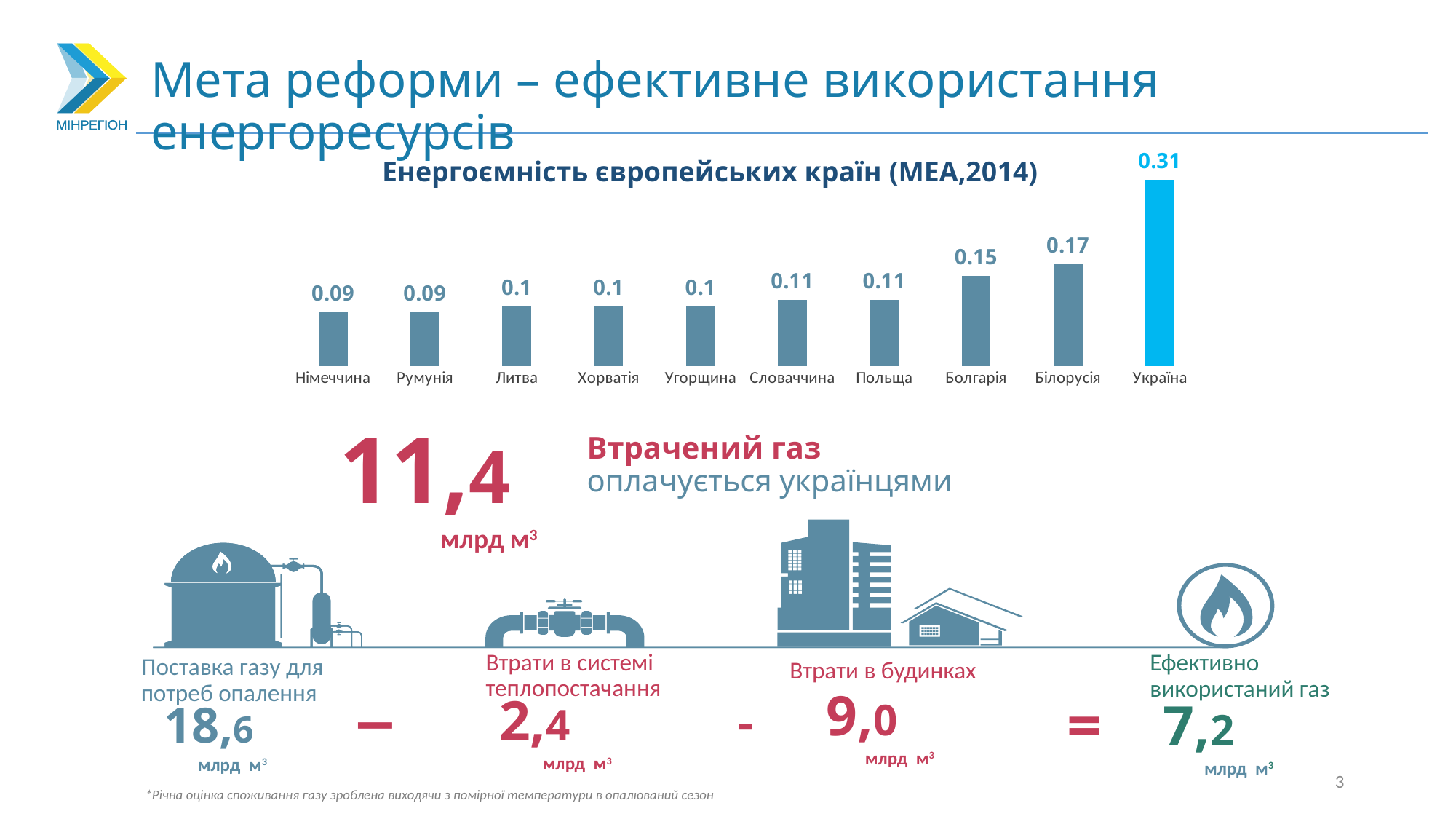
What is the value for Білорусія in the chart? 0.17 What is the value for Україна in the chart 'Енергоємність європейських країн (МЕА,2014)'? 0.31 How many countries are shown in the chart? 10 What is the value for Німеччина in the chart? 0.09 What is the value for Словаччина in the chart? 0.11 What is the difference between the values for Болгарія and Польща? 0.04 What is the difference between the values for Україна and Білорусія? 0.14 Do the values in the chart rise or fall from left to right? Rise Which has a larger value, Болгарія or Польща? Болгарія Which country has the highest value in the chart? Україна What kind of chart is used to show the energy intensity of European countries? Bar chart What is the value for Болгарія in the chart? 0.15